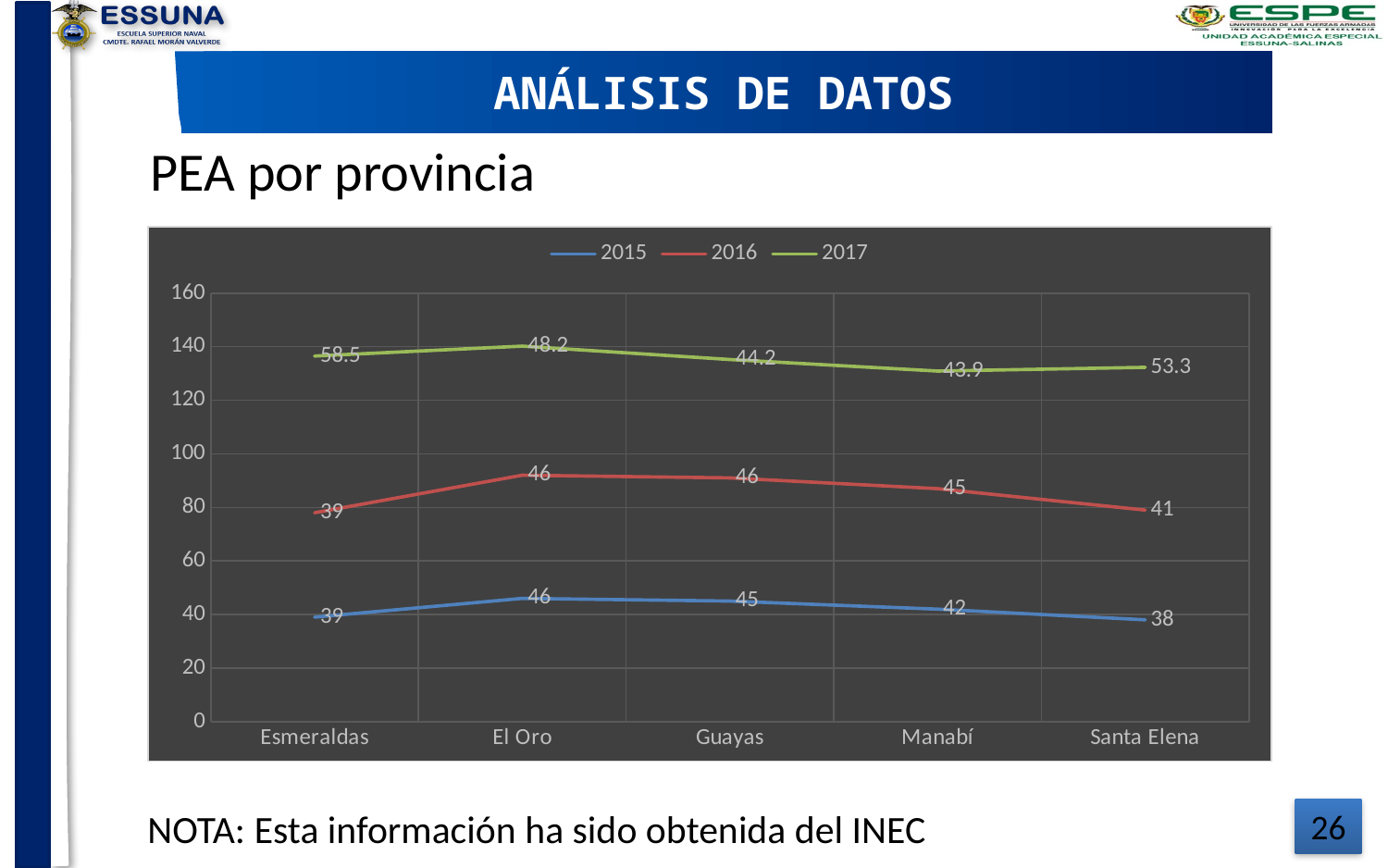
How many series does the legend list? 3 What is the 2016 value for Santa Elena? 41 Which is larger, the 2016 value for Manabí or the 2016 value for Santa Elena? Manabí What is the 2015 value for El Oro? 46 Which province has the highest 2017 value? Esmeraldas What is the difference between the 2017 values for Esmeraldas and Santa Elena? 5.2 What is the title shown above the chart? PEA por provincia Which province has the lowest 2015 value? Santa Elena What is the 2017 value for Manabí? 43.9 What kind of chart is shown on the slide? Line chart How many provinces are shown on the x axis? 5 What is the 2017 value for Esmeraldas? 58.5